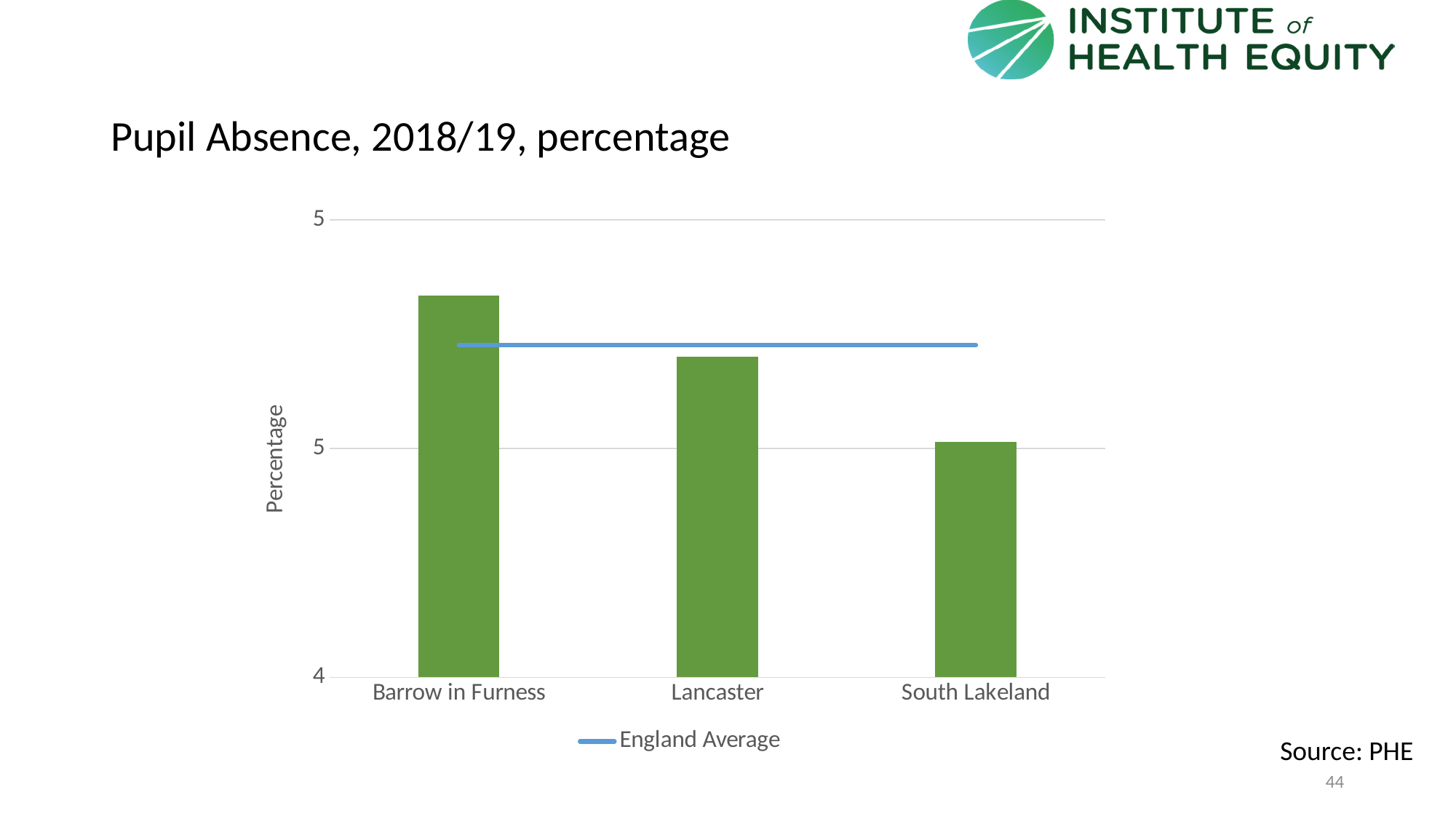
Which is larger, the value for Lancaster or the value for South Lakeland? Lancaster How many entries does the legend list? 1 Which is larger, the value for Barrow in Furness or the value for Lancaster? Barrow in Furness Is the value for South Lakeland above or below the England Average line? below Do the bar values rise or fall from left to right across the x axis? fall Which category has the lowest pupil absence percentage? South Lakeland Which category has the highest pupil absence percentage? Barrow in Furness What kind of chart is shown on the slide? combination bar and line chart What is the title of the chart? Pupil Absence, 2018/19, percentage What label is shown on the y axis? Percentage How many categories are plotted on the x axis? 3